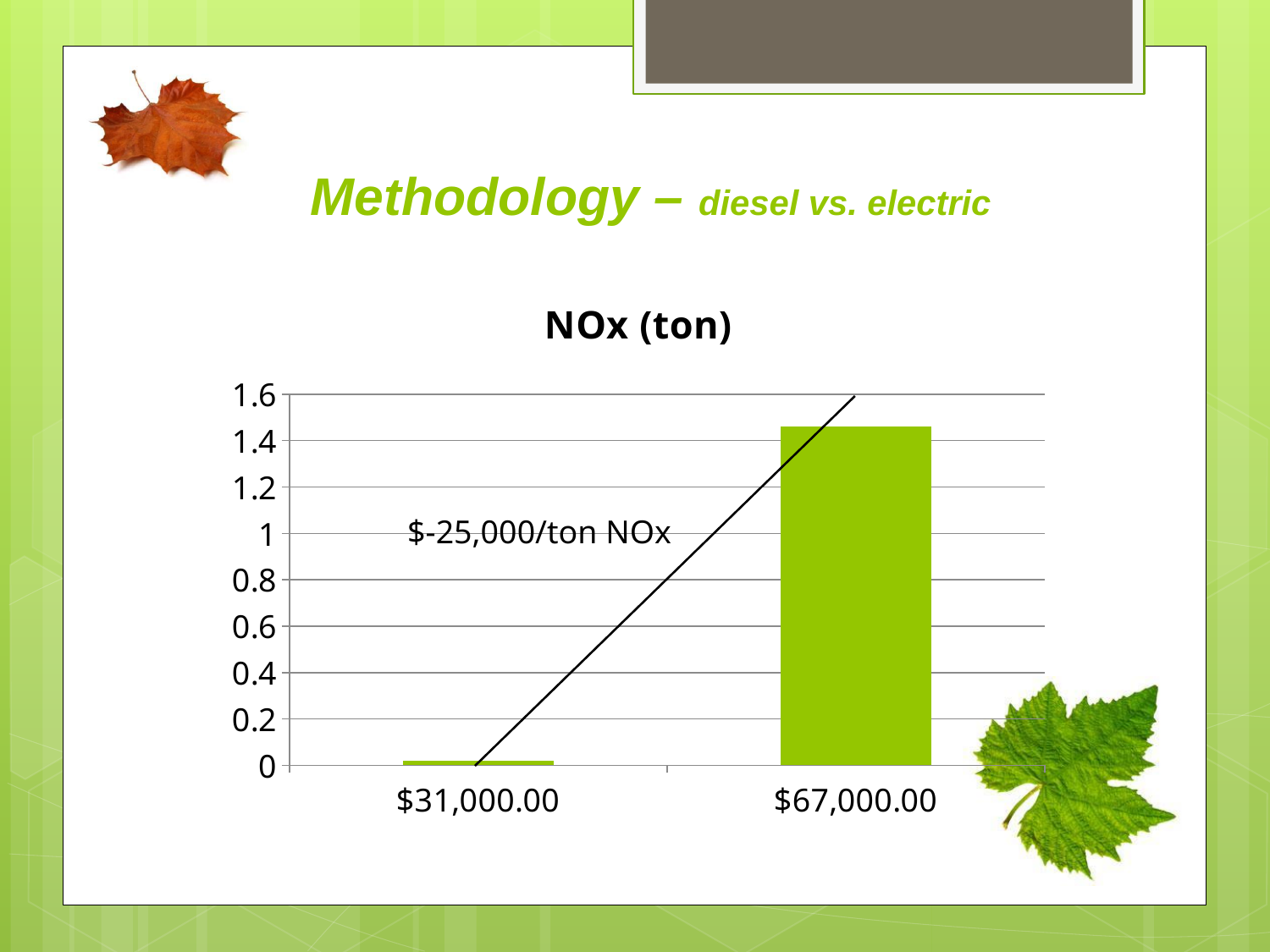
Which category has the lowest NOx value? $31,000.00 What kind of chart is shown on the slide? bar chart Which is larger, the value for $31,000.00 or the value for $67,000.00? $67,000.00 Is the value for $67,000.00 greater or less than 1.2? greater What is the title of the chart? NOx (ton) Which category has the highest NOx value? $67,000.00 Do the values rise or fall from left to right along the x axis? rise Is the value for $31,000.00 greater or less than 0.2? less What text annotation is written next to the line on the chart? $-25,000/ton NOx Is the value for $67,000.00 greater or less than 1.6? less What is the highest value shown on the vertical axis? 1.6 How many bars does the chart show? 2